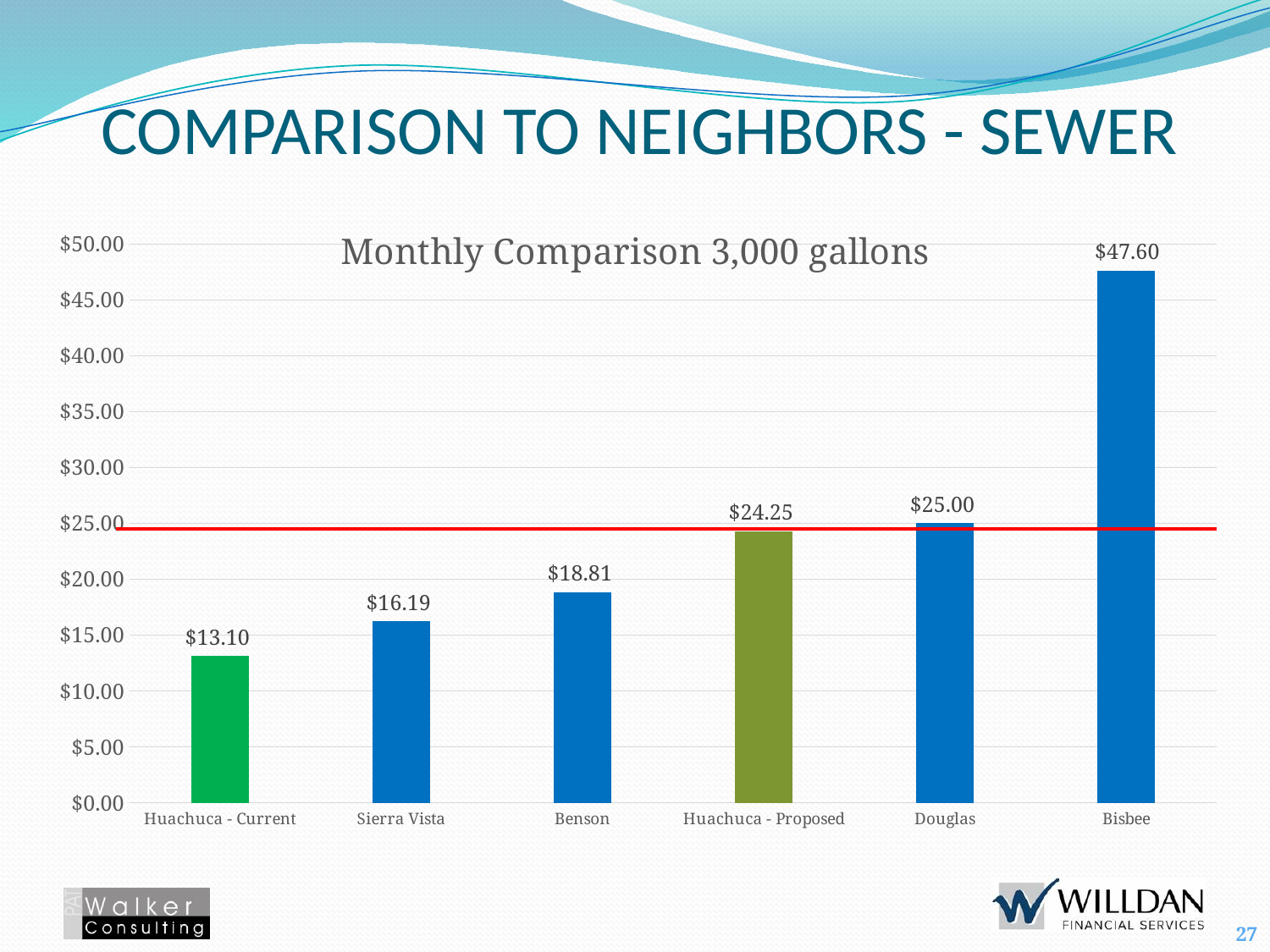
What is the value for Bisbee? $47.60 What is the value for Huachuca - Proposed? $24.25 What kind of chart is shown? bar chart What is the title of the chart? Monthly Comparison 3,000 gallons What is the difference between Huachuca - Proposed and Huachuca - Current? $11.15 What is the value for Benson? $18.81 How many categories are shown on the x axis? 6 Is the value for Douglas greater or less than $20.00? greater Which is larger, the value for Sierra Vista or the value for Benson? Benson Which category has the lowest value? Huachuca - Current Which category has the highest value? Bisbee What is the value for Huachuca - Current? $13.10